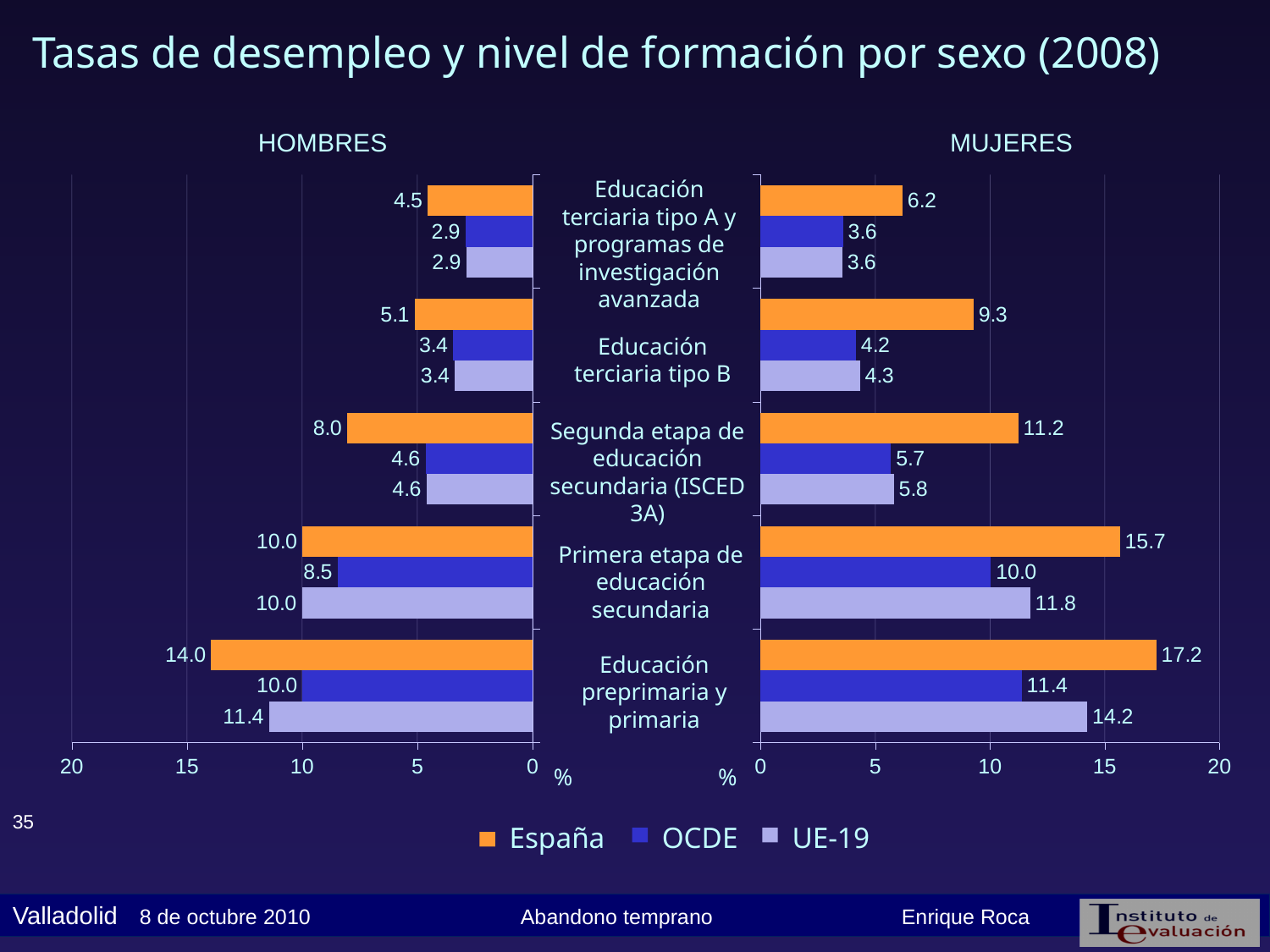
How many series does the legend list? 3 In the MUJERES chart, what is the difference between the España and OCDE values for Educación preprimaria y primaria? 5.8 In the MUJERES chart, which education level has the lowest value for España? Educación terciaria tipo A y programas de investigación avanzada How many education levels are shown in the HOMBRES chart? 5 In the MUJERES chart, what is the value for OCDE in Educación terciaria tipo B? 4.2 In the HOMBRES chart, what is the difference between the España and UE-19 values for Segunda etapa de educación secundaria (ISCED 3A)? 3.4 Which is larger: the España value for Educación terciaria tipo B in the HOMBRES chart or in the MUJERES chart? MUJERES In the MUJERES chart, what is the value for UE-19 in Primera etapa de educación secundaria? 11.8 Which series is shown in orange in the legend? España In the HOMBRES chart, which education level has the highest value for España? Educación preprimaria y primaria What kind of chart is the MUJERES chart? Bar chart In the HOMBRES chart, what is the value for España in Educación preprimaria y primaria? 14.0